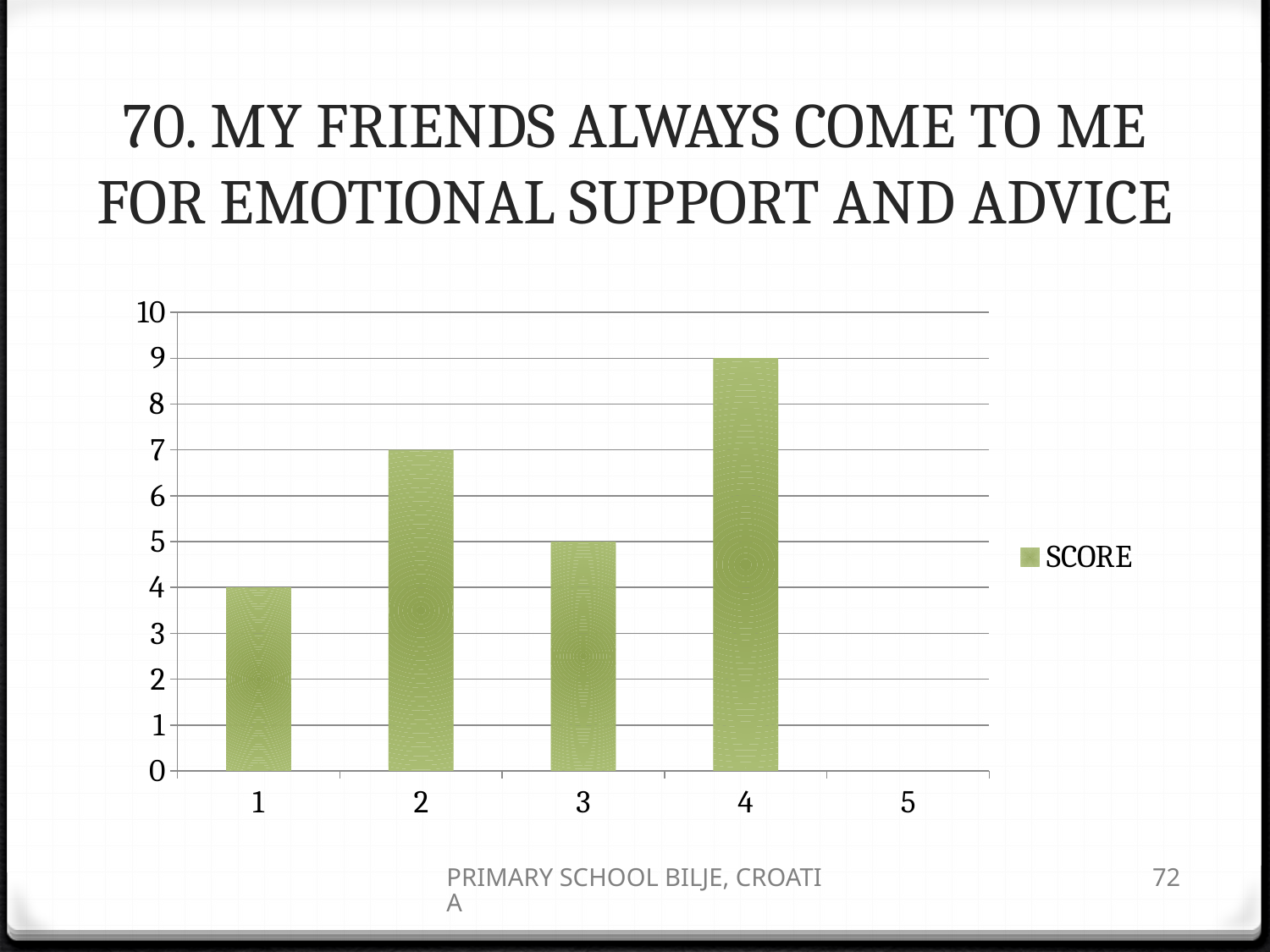
What is the value for category 2? 7 Which is larger, the value for category 2 or the value for category 3? category 2 Is the value for category 4 greater or less than 8? greater What kind of chart is shown on the slide? bar chart What is the difference between the values for category 4 and category 1? 5 What is the value for category 4? 9 What is the difference between the values for category 2 and category 3? 2 How many series does the legend list? 1 What is the value for category 3? 5 Which category has the highest value? 4 What is the value for category 1? 4 How many categories are shown on the x axis? 5